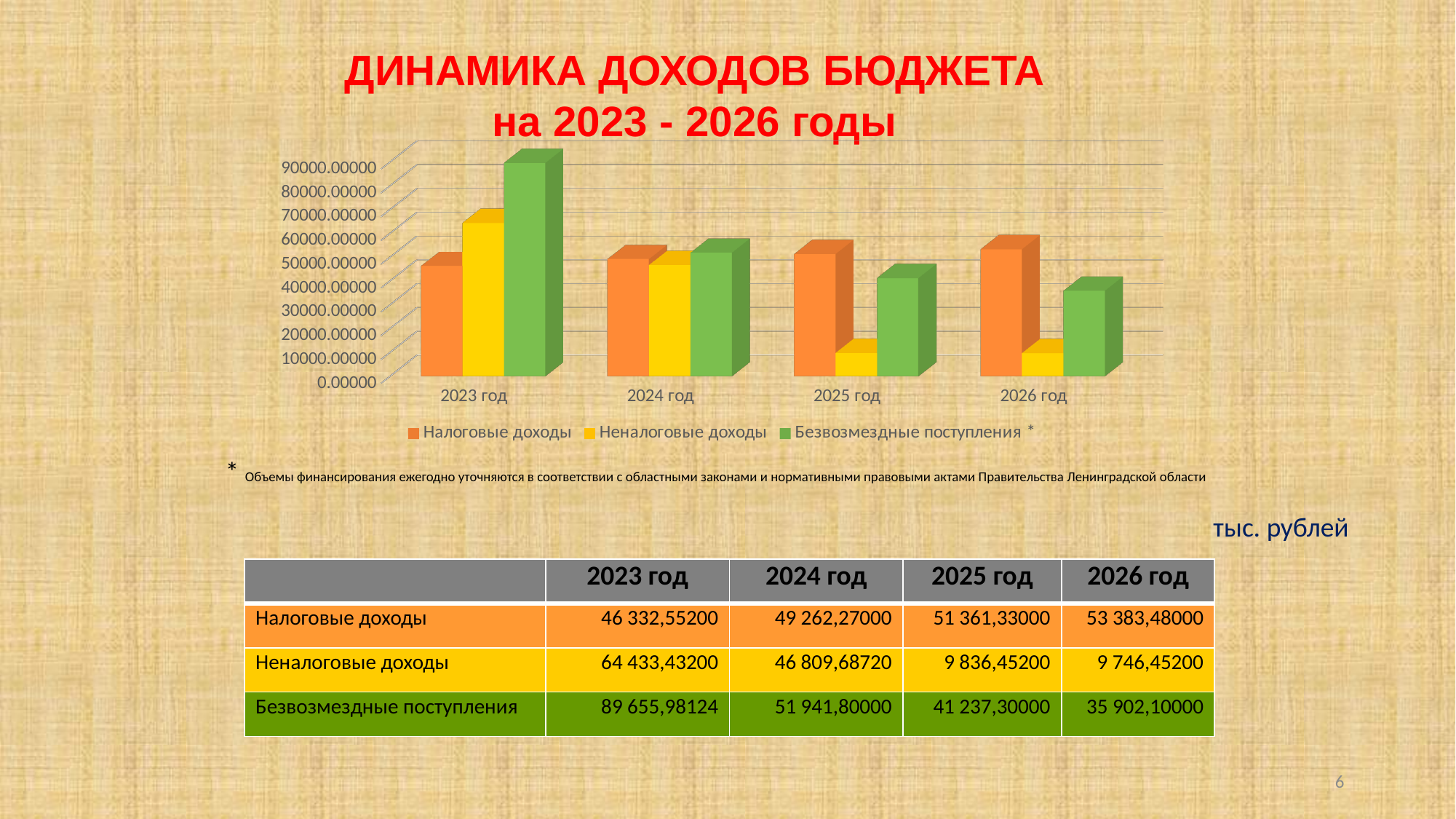
Is the value of Безвозмездные поступления for 2023 год greater or less than 80000? greater How many year categories are shown on the x axis of the chart? 4 Do the values of Налоговые доходы rise or fall from 2023 год to 2026 год? Rise Which series has the lowest value in 2025 год? Неналоговые доходы What is the value of Неналоговые доходы for 2024 год? 46 809,68720 What is the value of Безвозмездные поступления for 2026 год? 35 902,10000 Which series has the highest value in 2023 год? Безвозмездные поступления What is the difference between Налоговые доходы in 2026 год and in 2023 год? 7 050,92800 What type of chart is shown on the slide? Bar chart In 2023 год, which is larger: Налоговые доходы or Неналоговые доходы? Неналоговые доходы How many series does the chart legend list? 3 What is the value of Налоговые доходы for 2023 год? 46 332,55200